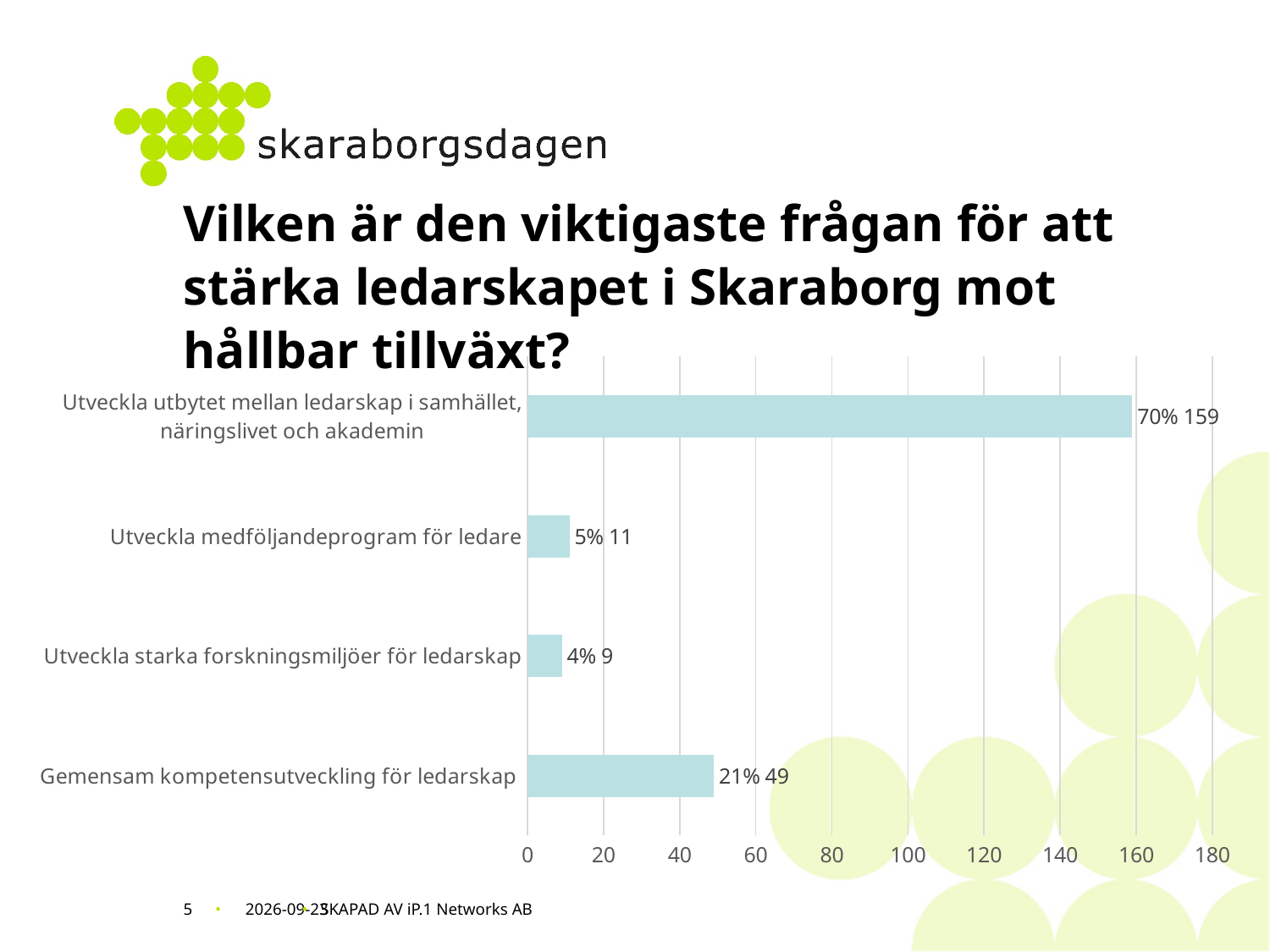
What is the data label for "Utveckla medföljandeprogram för ledare"? 5% 11 What is the data label for "Utveckla starka forskningsmiljöer för ledarskap"? 4% 9 What is the data label for "Gemensam kompetensutveckling för ledarskap"? 21% 49 Is the value for "Gemensam kompetensutveckling för ledarskap" greater or less than 60? less Which category has the lowest value? Utveckla starka forskningsmiljöer för ledarskap What is the data label for "Utveckla utbytet mellan ledarskap i samhället, näringslivet och akademin"? 70% 159 What is the highest value shown on the x axis? 180 Which has a larger value: "Utveckla medföljandeprogram för ledare" or "Gemensam kompetensutveckling för ledarskap"? Gemensam kompetensutveckling för ledarskap What is the difference in count between "Utveckla utbytet mellan ledarskap i samhället, näringslivet och akademin" (159) and "Gemensam kompetensutveckling för ledarskap" (49)? 110 What kind of chart is shown on the slide? bar chart Which category has the highest value? Utveckla utbytet mellan ledarskap i samhället, näringslivet och akademin How many categories does the chart show? 4